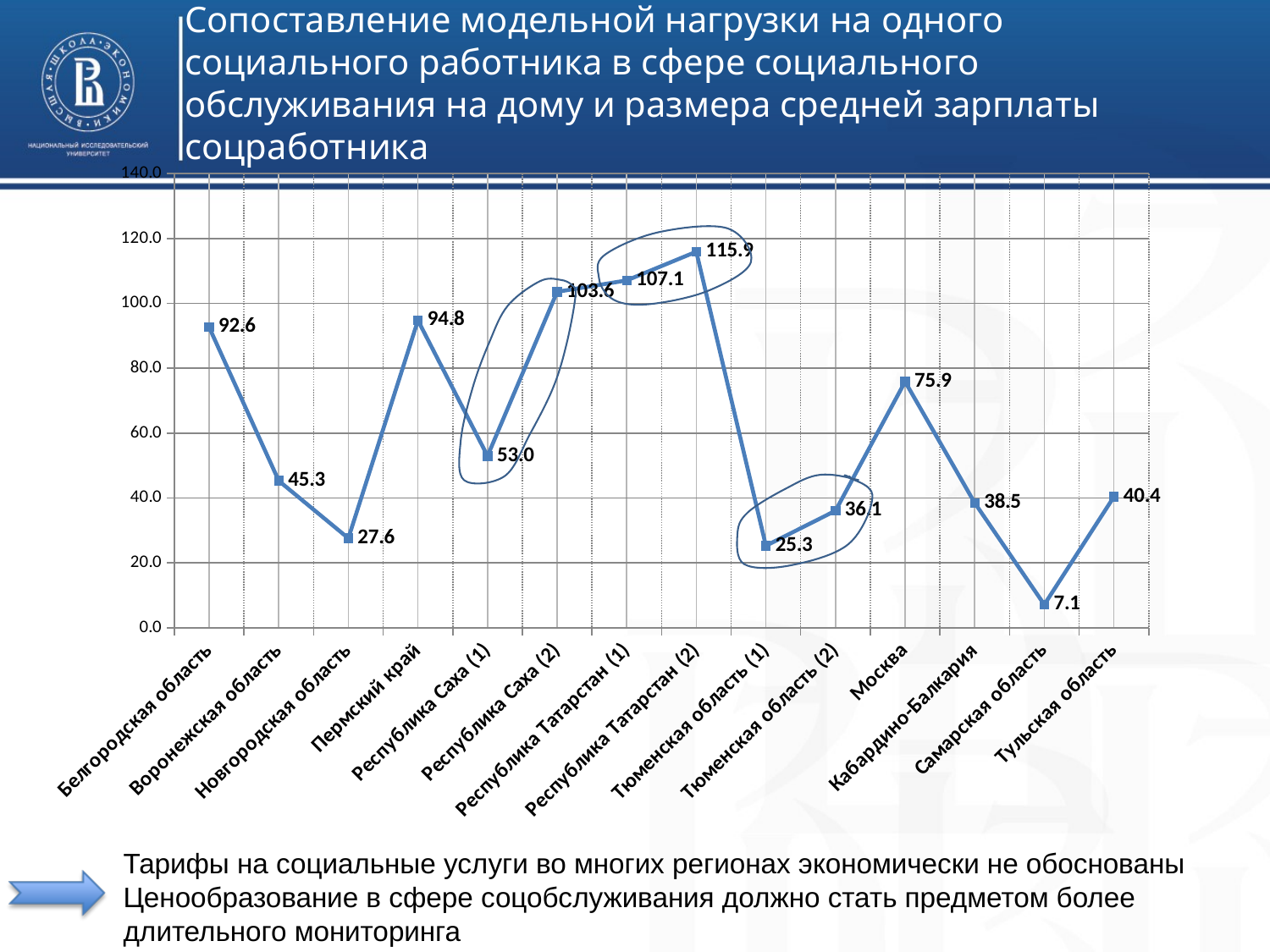
What is the difference between the values for Тюменская область (2) and Тюменская область (1)? 10.8 Which is larger, the value for Пермский край or the value for Белгородская область? Пермский край What is the value for Республика Татарстан (2)? 115.9 Which category has the highest value? Республика Татарстан (2) Which category has the lowest value? Самарская область What is the value for Тюменская область (1)? 25.3 What type of chart is shown on the slide? line chart Does the value rise or fall from Кабардино-Балкария to Самарская область? fall What is the difference between the values for Республика Саха (2) and Республика Саха (1)? 50.6 What is the value for Белгородская область? 92.6 What is the value for Москва? 75.9 How many categories are plotted on the x axis? 14